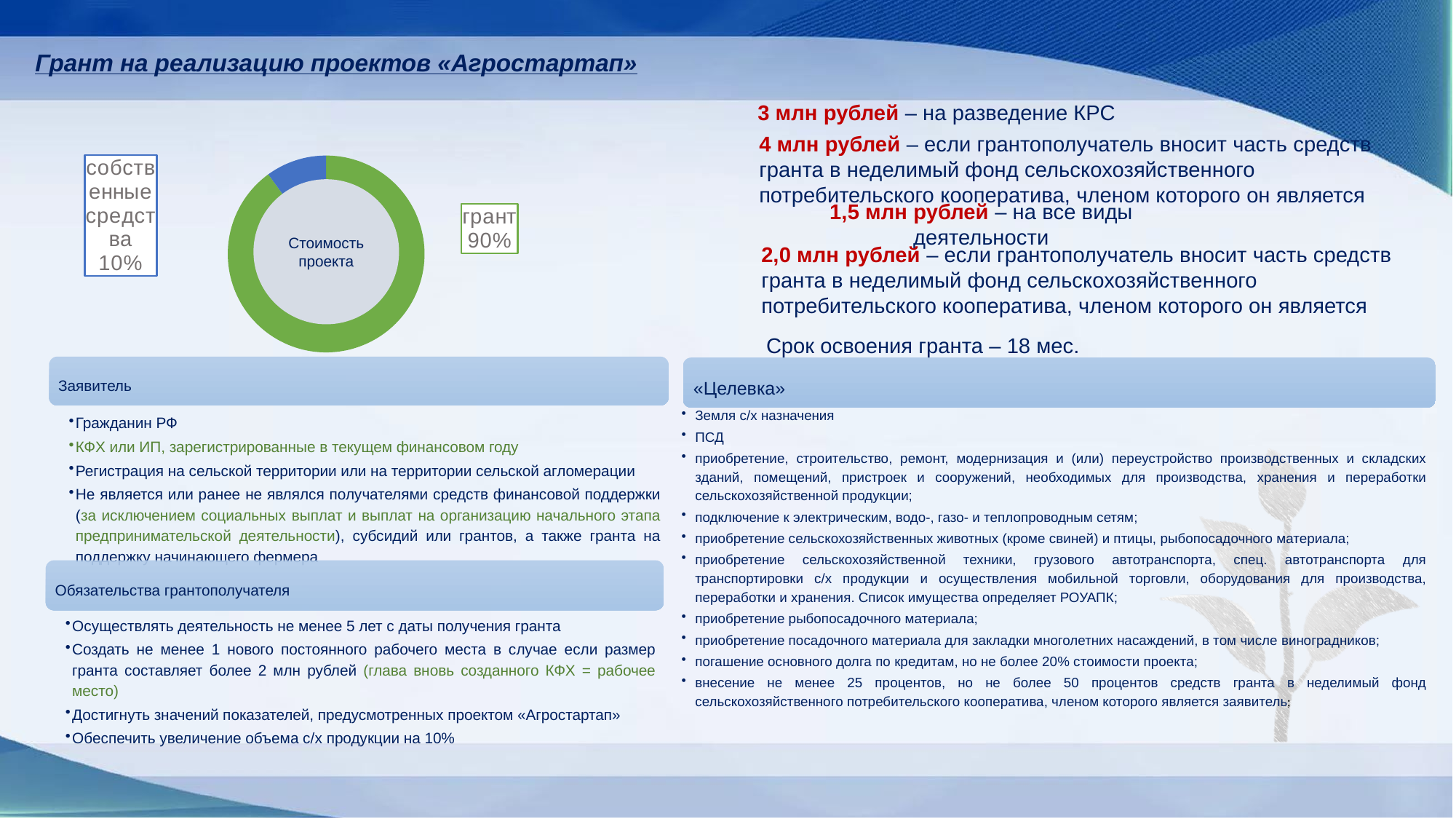
Which segment of the chart is the smallest? собственные средства What share of the project cost comes from own funds (собственные средства) according to the chart? 10% What share of the project cost does the grant (грант) make up according to the chart? 90% What is the total of the two shares shown in the chart? 100% What kind of chart is shown on the slide? doughnut chart Which is larger in the chart: the grant share or the own-funds share? грант By how many percentage points does the grant share exceed the own-funds share in the chart? 80 How many segments does the chart have? 2 What colour is the grant (грант) segment of the chart? green What text is shown in the centre of the doughnut chart? Стоимость проекта Which segment of the chart is the largest? грант